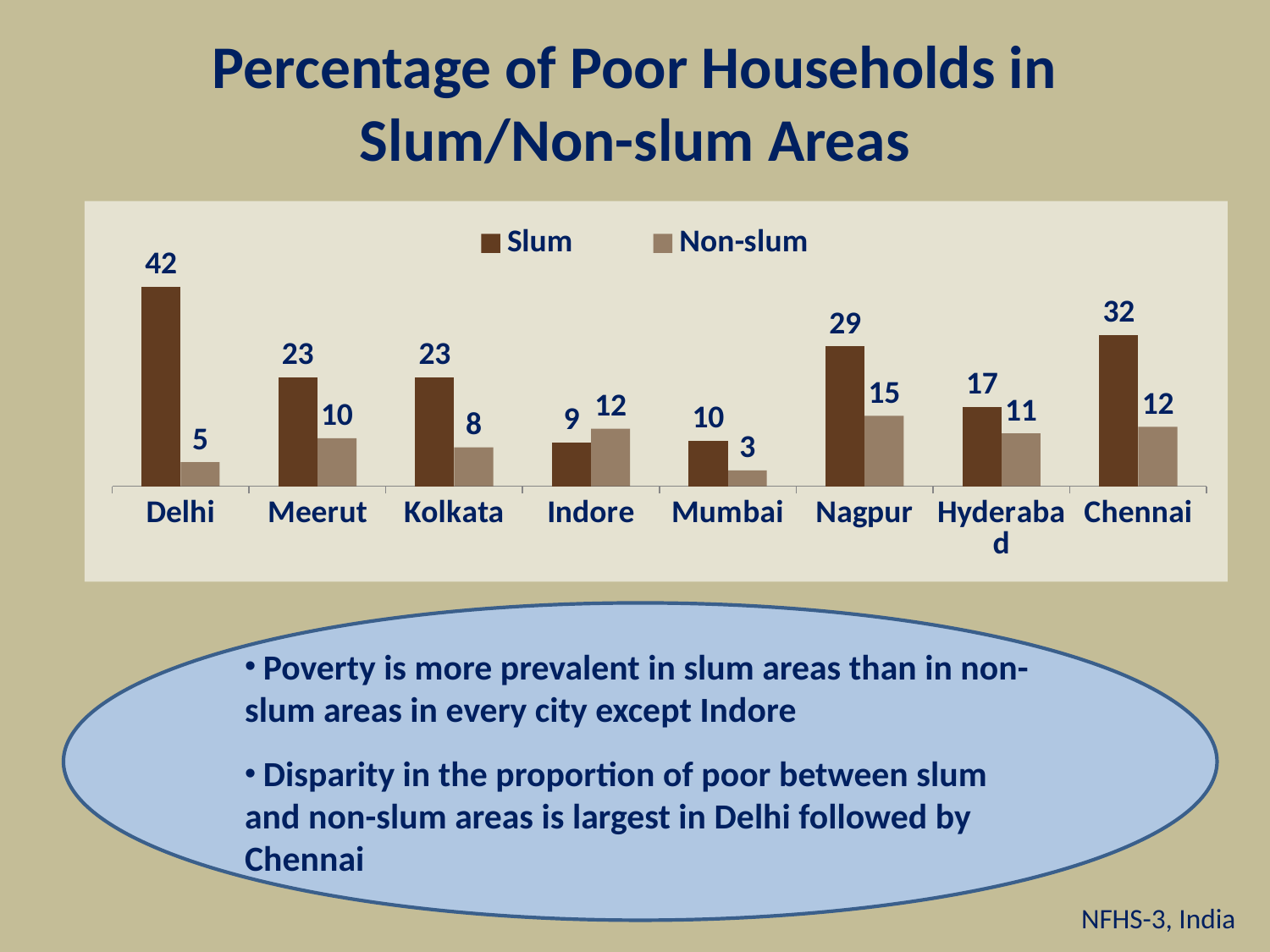
What are the two series named in the legend? Slum and Non-slum What kind of chart is shown on the slide? Bar chart Which city has the highest Slum value? Delhi What is the difference between the Slum and Non-slum values for Chennai? 20 How many series does the legend list? 2 What is the Non-slum value for Indore? 12 What is the Slum value for Delhi? 42 Which is larger for Indore, the Slum value or the Non-slum value? Non-slum Which city has the lowest Non-slum value? Mumbai What is the Non-slum value for Mumbai? 3 How many cities are shown on the x axis? 8 Which city has a larger Slum value, Nagpur or Hyderabad? Nagpur